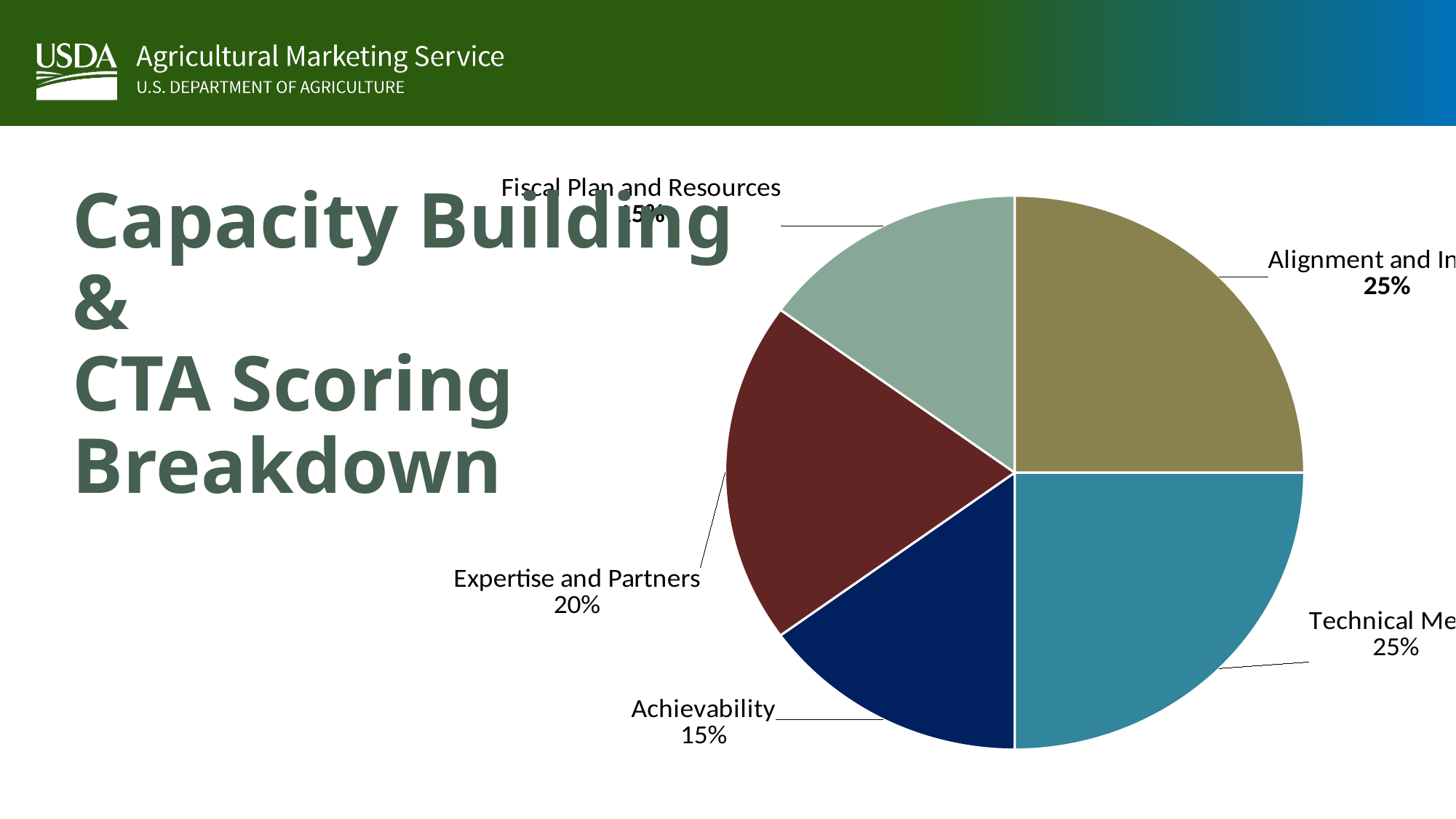
What colour is the Achievability slice of the pie chart? Dark navy blue Which slice is larger, Expertise and Partners or Achievability? Expertise and Partners What is the title shown on the slide next to the chart? Capacity Building & CTA Scoring Breakdown By how many percentage points does Expertise and Partners exceed Achievability? 5 How many slices does the pie chart have? 5 What type of chart is shown on the slide? Pie chart What percentage of the pie chart does Expertise and Partners account for? 20% What share of the pie does the Achievability slice represent? 15% What percentage of the pie chart does Achievability account for? 15% Is the share for Expertise and Partners greater or less than 25%? less